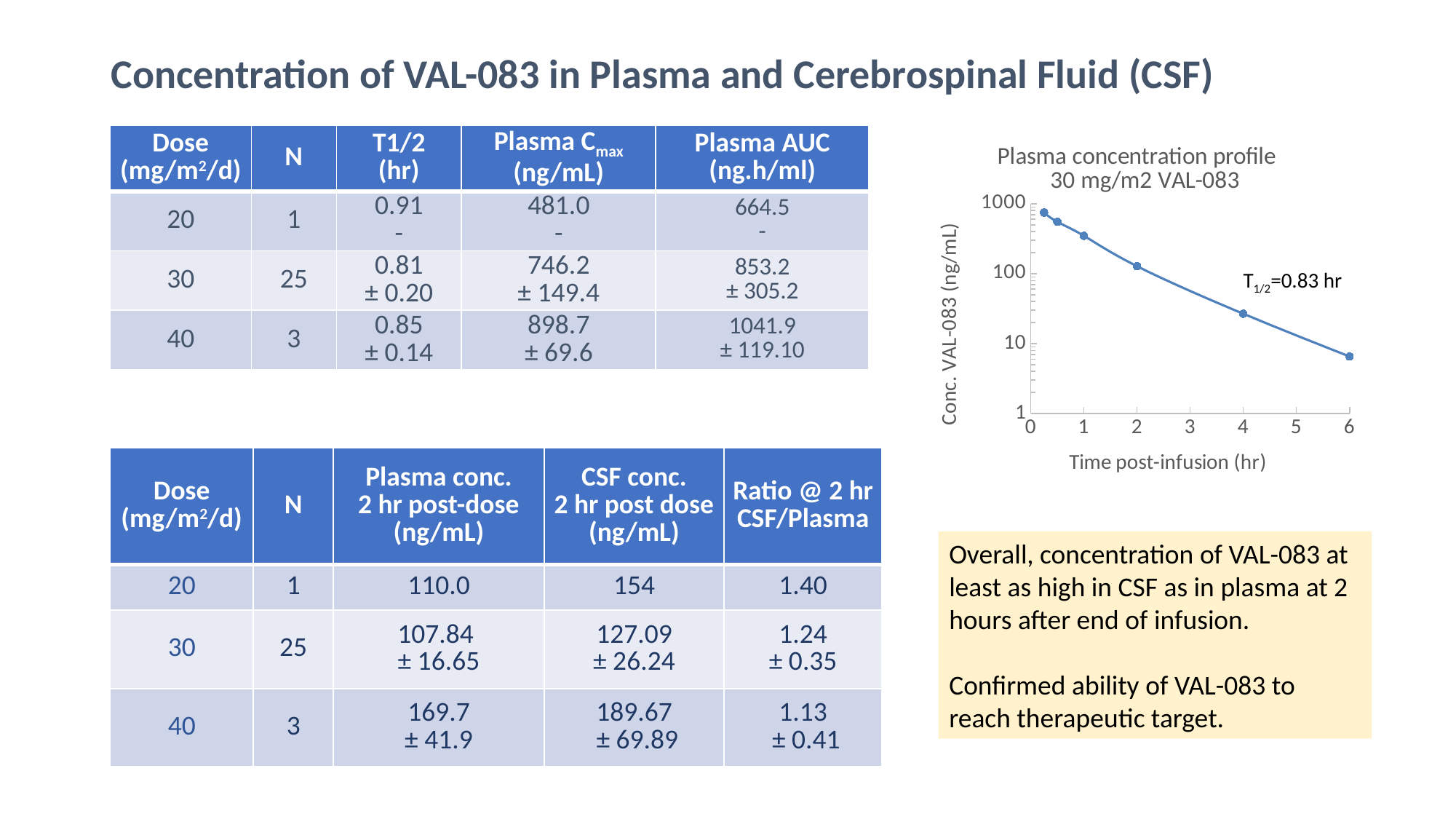
What is the label of the x axis of the chart? Time post-infusion (hr) Does the plasma concentration rise or fall as time post-infusion increases? fall What half-life value is annotated on the chart? T1/2=0.83 hr At which time post-infusion is the plotted concentration lowest? 6 hr How many data points are plotted on the chart? 6 Is the concentration at 2 hr post-infusion greater or less than 100? greater What kind of chart is shown on the slide? line chart Is the concentration at 6 hr post-infusion greater or less than 10? less What is the title of the chart? Plasma concentration profile 30 mg/m2 VAL-083 Which is larger, the concentration at 1 hr or at 4 hr post-infusion? 1 hr Is the concentration at 1 hr post-infusion greater or less than 1000? less